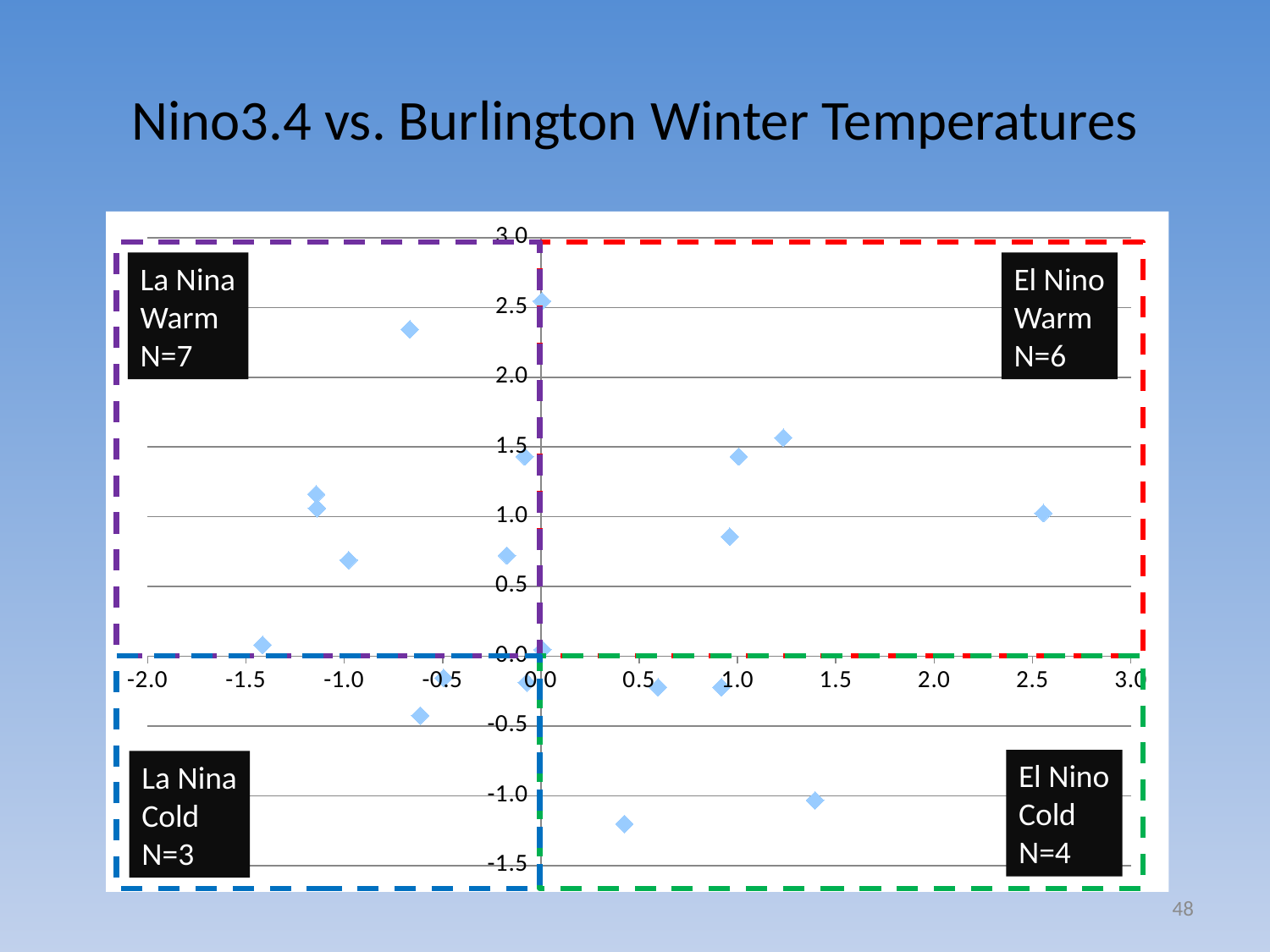
Is the highest plotted point on the chart greater or less than 2.0 on the vertical axis? greater How many points (N) are in the La Nina Cold quadrant? 3 How many points (N) are in the El Nino Cold quadrant? 4 Which quadrant has more points, La Nina Warm or El Nino Warm? La Nina Warm How many points (N) are in the La Nina Warm quadrant? 7 What kind of chart is shown on the slide? scatter chart How many more points are in the El Nino Warm quadrant than in the El Nino Cold quadrant? 2 Which quadrant has the smallest number of points (N)? La Nina Cold Which quadrant has the largest number of points (N)? La Nina Warm Is the lowest plotted point on the chart greater or less than -1.0 on the vertical axis? less How many points (N) are in the El Nino Warm quadrant? 6 What is the title of the chart? Nino3.4 vs. Burlington Winter Temperatures